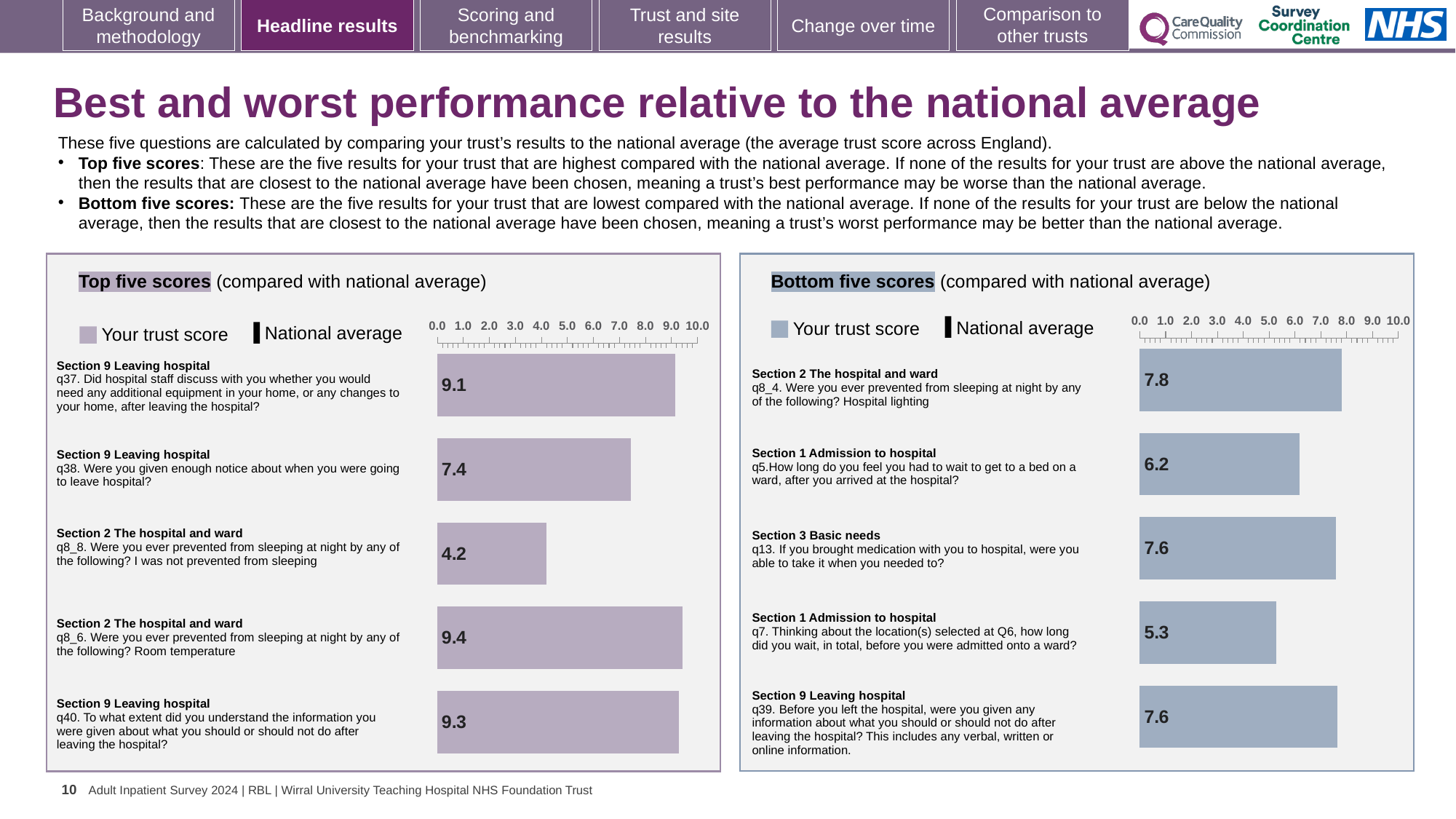
On the Bottom five scores chart, which question has the lowest trust score? q7 On the Bottom five scores chart, what is the trust score for q8_4 (Hospital lighting)? 7.8 On the Bottom five scores chart, what is the trust score for q7 (how long you waited before being admitted onto a ward)? 5.3 On the Top five scores chart, what is the trust score for q8_8 (not prevented from sleeping)? 4.2 On the Bottom five scores chart, is the trust score for q5 larger or smaller than the trust score for q13? smaller What type of chart is used for the Top five scores? Bar chart On the Top five scores chart, what is the trust score for q37 (discussing additional equipment or changes to your home after leaving hospital)? 9.1 On the Bottom five scores chart, which question has the highest trust score? q8_4 (Hospital lighting) On the Top five scores chart, what is the difference between the trust scores for q8_6 and q38? 2.0 On the Top five scores chart, which question has the lowest trust score? q8_8 (I was not prevented from sleeping) On the Top five scores chart, which question has the highest trust score? q8_6 (Room temperature) How many bars are shown on the Bottom five scores chart? 5